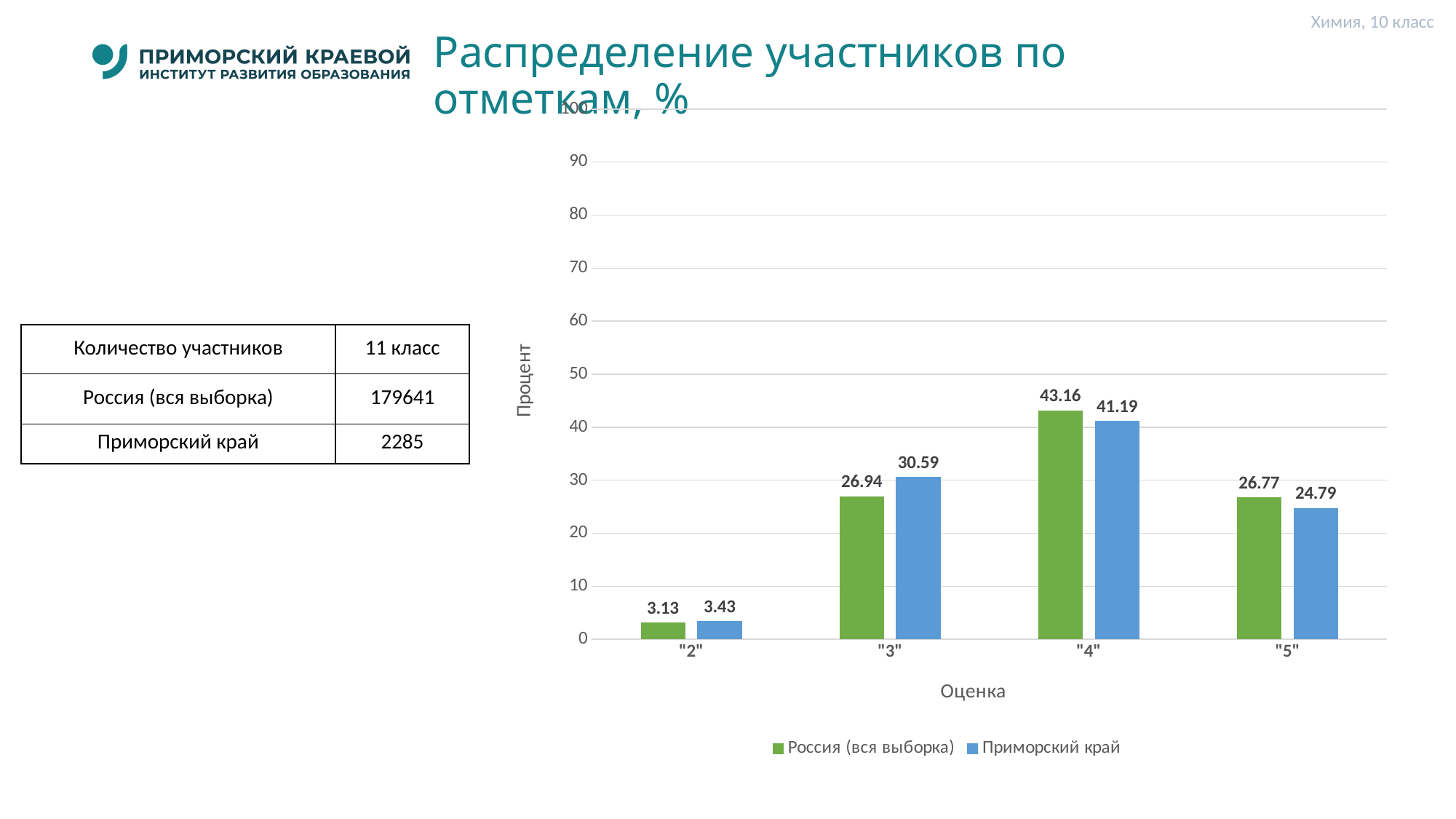
How many grade categories are shown on the x axis? 4 What is the value for Приморский край at grade "2"? 3.43 What is the value for Россия (вся выборка) at grade "5"? 26.77 Which grade has the highest value for Приморский край? "4" Which grade has the lowest value for Россия (вся выборка)? "2" What is the value for Россия (вся выборка) at grade "4"? 43.16 What is the difference between Россия (вся выборка) and Приморский край at grade "4"? 1.97 What is the value for Приморский край at grade "3"? 30.59 At grade "3", which series has the larger value: Россия (вся выборка) or Приморский край? Приморский край How many series does the legend list? 2 Is the value for Приморский край at grade "5" greater or less than 30? less What kind of chart is shown on the slide? bar chart